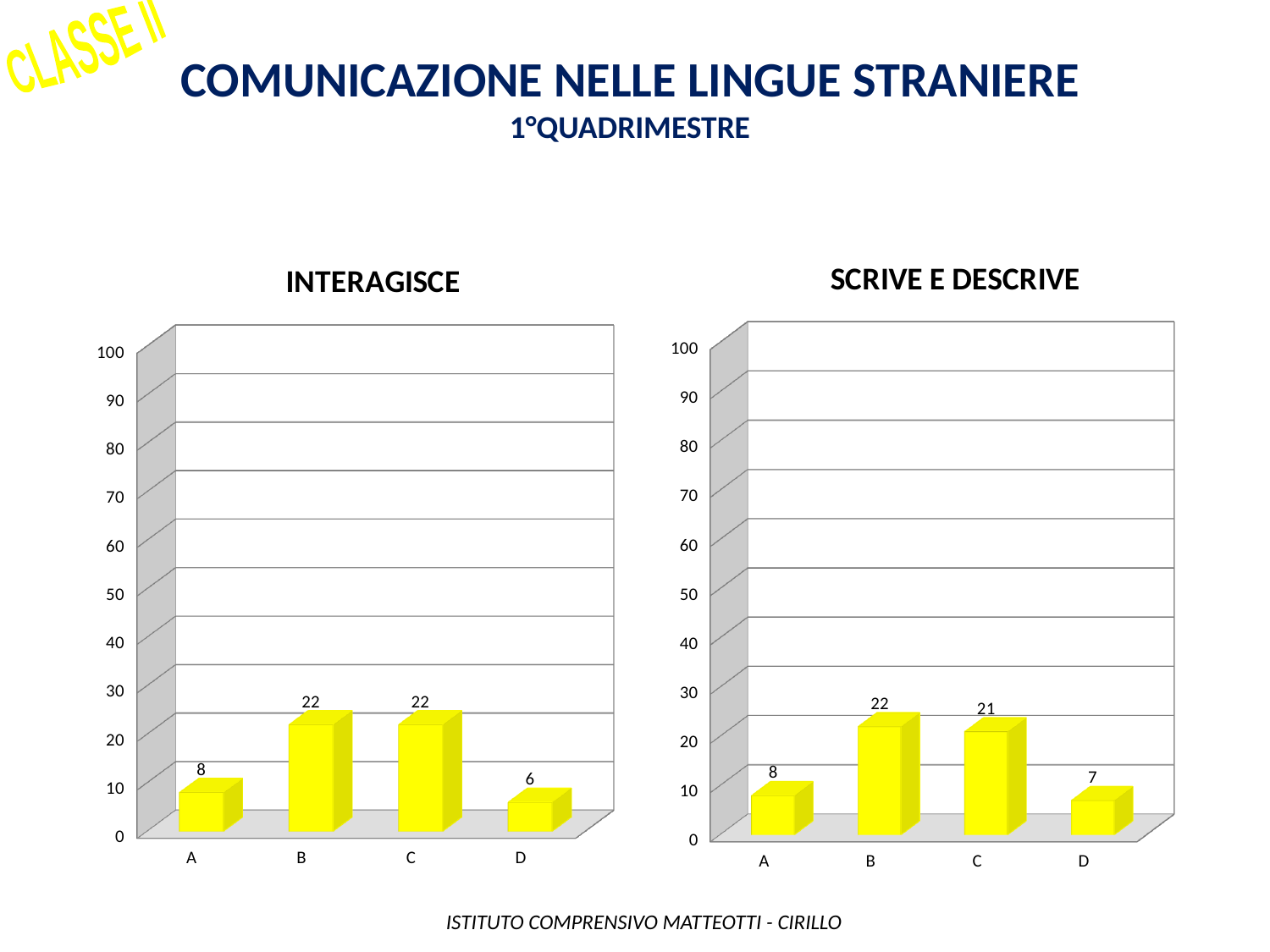
In the INTERAGISCE chart, which is larger, the value for A or the value for D? A In the INTERAGISCE chart, what is the value for category B? 22 In the INTERAGISCE chart, what is the difference between the values for B and A? 14 In the INTERAGISCE chart, what is the value for category D? 6 How many categories are shown in the INTERAGISCE chart? 4 In the SCRIVE E DESCRIVE chart, is the value for B greater or less than 30? less In the SCRIVE E DESCRIVE chart, what is the value for category C? 21 What kind of chart is the SCRIVE E DESCRIVE chart? bar chart In the SCRIVE E DESCRIVE chart, what is the difference between the values for C and D? 14 What is the title of the chart on the left of the slide? INTERAGISCE In the SCRIVE E DESCRIVE chart, which category has the highest value? B In the SCRIVE E DESCRIVE chart, which category has the lowest value? D